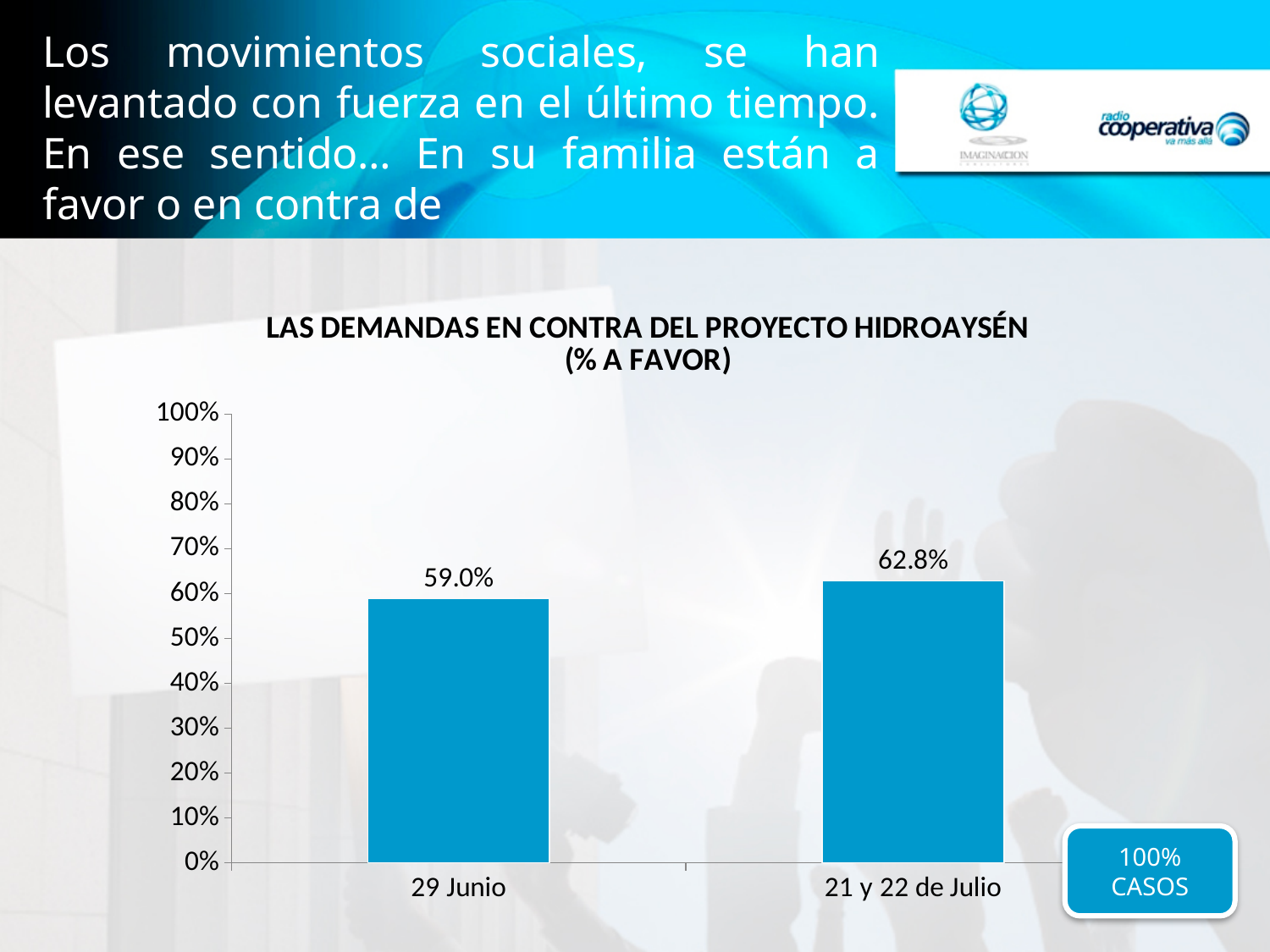
Which category has the highest value? 21 y 22 de Julio Is the value for 29 Junio greater or less than 50%? greater Which category has the lowest value? 29 Junio What is the title of the chart? LAS DEMANDAS EN CONTRA DEL PROYECTO HIDROAYSÉN (% A FAVOR) Which is larger, the value for 29 Junio or the value for 21 y 22 de Julio? 21 y 22 de Julio How many categories are shown on the x axis? 2 Do the values rise or fall from 29 Junio to 21 y 22 de Julio? rise What is the difference between the values for 21 y 22 de Julio and 29 Junio? 3.8% Is the value for 21 y 22 de Julio greater or less than 70%? less What kind of chart is shown on the slide? bar chart What is the value for 21 y 22 de Julio? 62.8% What is the value for 29 Junio? 59.0%